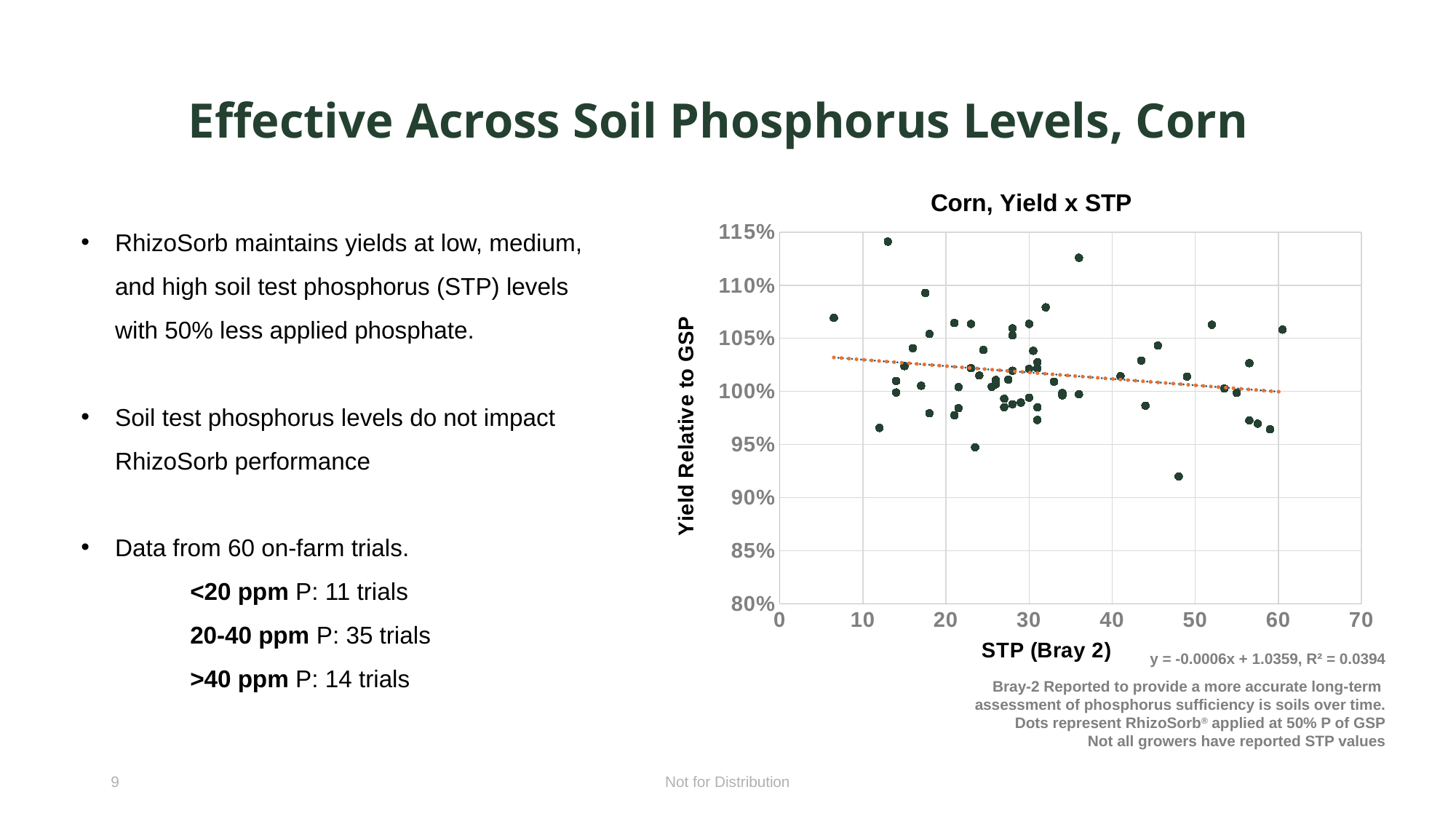
What is the title of the chart? Corn, Yield x STP What is the trendline equation shown below the chart? y = -0.0006x + 1.0359 What R² value is reported for the trendline? 0.0394 What is the label of the y axis of the chart? Yield Relative to GSP What is the lowest value shown on the y axis? 80% What is the highest value shown on the x axis? 70 According to the dotted trendline, do yields rise or fall as STP increases? Fall slightly What is the highest value shown on the y axis? 115% Is the plotted point near STP 36 at the top of the chart greater or less than 110%? greater What kind of chart is shown on the slide? Scatter chart Is the lowest plotted point (near STP 48) greater or less than 95%? less Is the highest plotted point (near STP 13) greater or less than 110%? greater